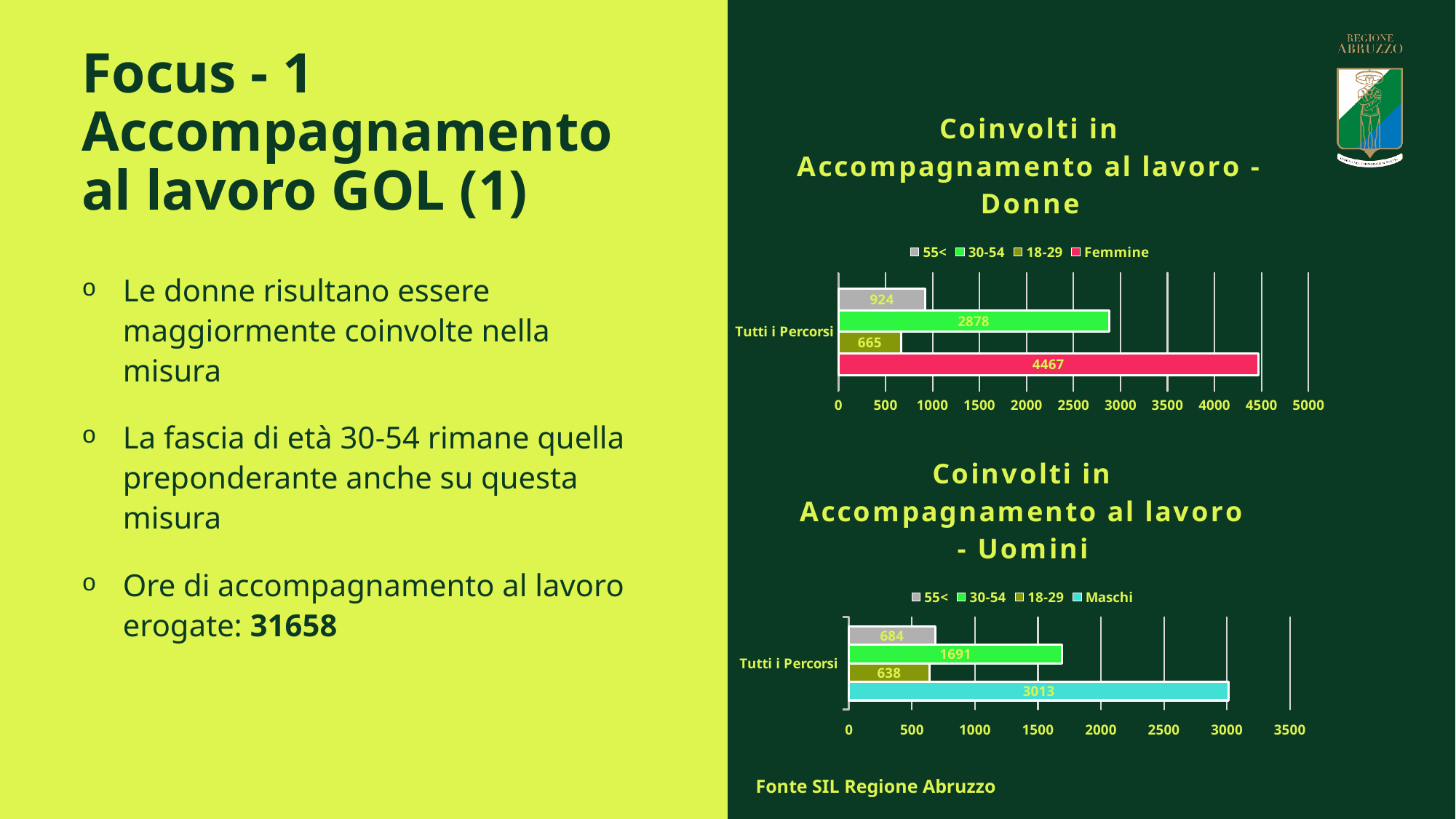
In the 'Coinvolti in Accompagnamento al lavoro - Donne' chart, which age-group series (55<, 30-54, 18-29) has the lowest value? 18-29 In the 'Coinvolti in Accompagnamento al lavoro - Uomini' chart, what is the value for the Maschi series? 3013 In the 'Coinvolti in Accompagnamento al lavoro - Donne' chart, what is the value for the 30-54 series? 2878 In the 'Coinvolti in Accompagnamento al lavoro - Donne' chart, what is the value for the Femmine series? 4467 How many series does the legend of the 'Coinvolti in Accompagnamento al lavoro - Donne' chart list? 4 In the 'Coinvolti in Accompagnamento al lavoro - Donne' chart, what is the difference between the 30-54 value and the 55< value? 1954 In the 'Coinvolti in Accompagnamento al lavoro - Uomini' chart, what is the value for the 18-29 series? 638 What kind of chart is the 'Coinvolti in Accompagnamento al lavoro - Uomini' chart? Bar chart In the 'Coinvolti in Accompagnamento al lavoro - Uomini' chart, is the value for 30-54 greater or less than 1500? greater In the 'Coinvolti in Accompagnamento al lavoro - Uomini' chart, which age-group series (55<, 30-54, 18-29) has the highest value? 30-54 Which is larger: the 30-54 value in the Donne chart or the 30-54 value in the Uomini chart? Donne chart (2878) In the 'Coinvolti in Accompagnamento al lavoro - Uomini' chart, what is the difference between the 55< value and the 18-29 value? 46